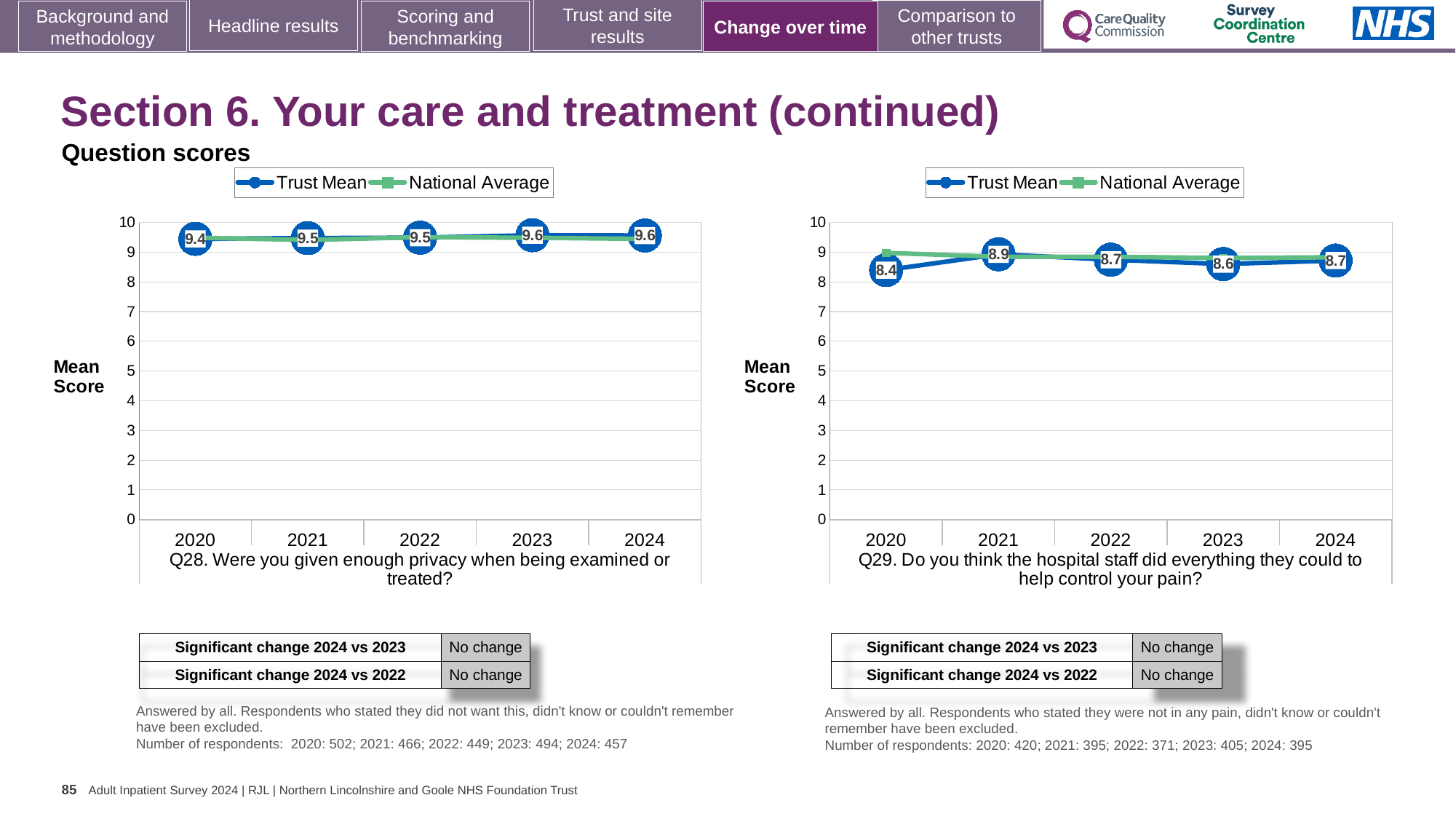
On the Q29 chart, what is the Trust Mean score for 2021? 8.9 On the Q29 chart, is the Trust Mean score for 2020 greater or less than 9? less How many series does the legend of the Q29 chart list? 2 On the Q28 chart, what is the Trust Mean score for 2020? 9.4 On the Q29 chart, which year has the highest Trust Mean score? 2021 How many years are plotted on the Q28 chart? 5 On the Q29 chart, what is the Trust Mean score for 2020? 8.4 On the Q28 chart, what is the difference between the Trust Mean scores for 2024 and 2020? 0.2 On the Q28 chart, what is the Trust Mean score for 2024? 9.6 On the Q29 chart, what is the difference between the Trust Mean scores for 2021 and 2020? 0.5 On the Q29 chart, which year has the lowest Trust Mean score? 2020 What type of chart is used for Q28? Line chart